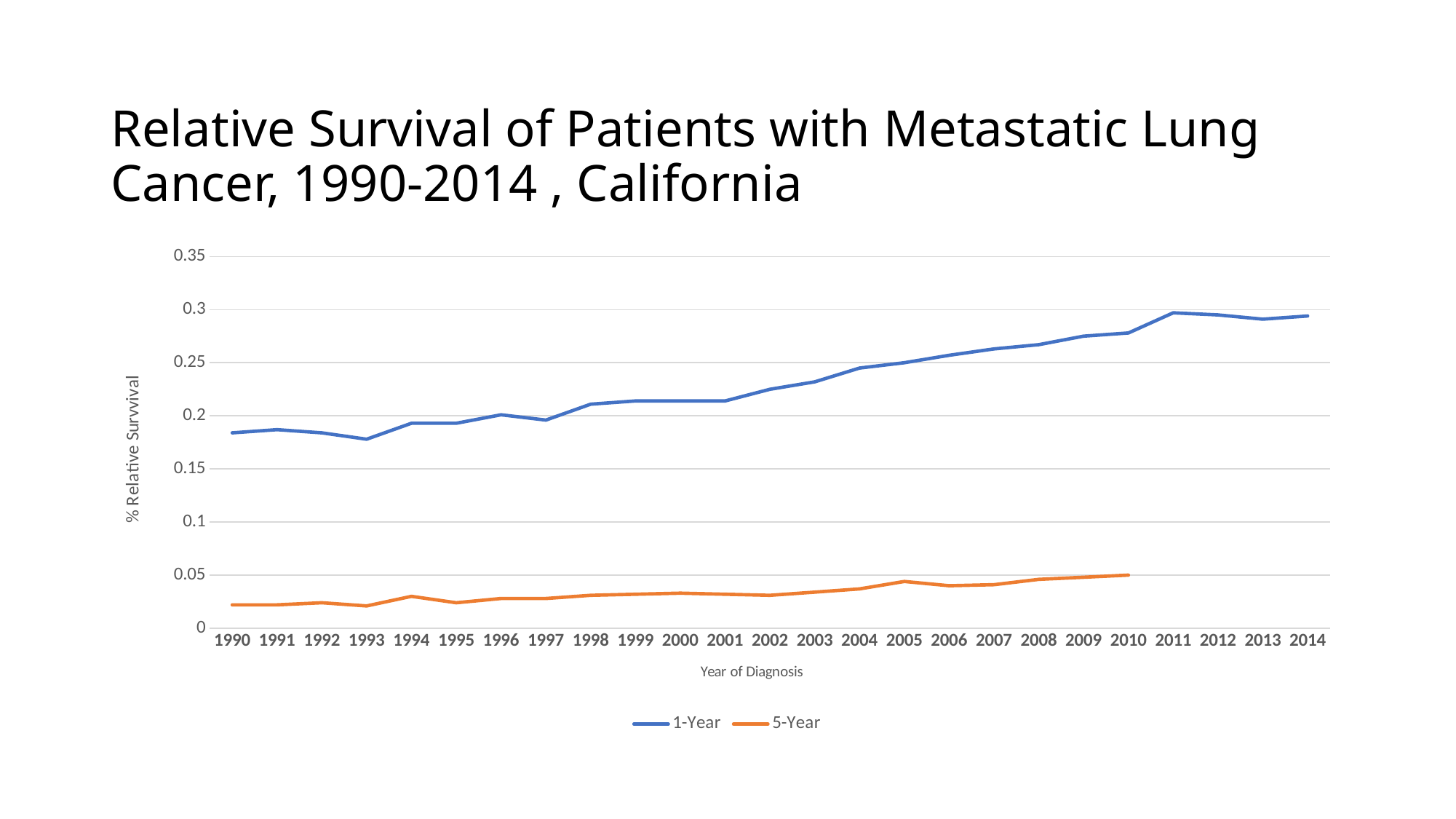
What kind of chart is shown on the slide? Line chart Which colour is used for the 5-Year series? Orange How many series does the legend list? 2 Which series has the larger value in 2000, 1-Year or 5-Year? 1-Year Is the 1-Year value for 2011 greater or less than 0.25? greater In which year is the 1-Year relative survival lowest? 1993 What is the label of the x axis? Year of Diagnosis Is the 1-Year value for 1990 greater or less than 0.2? less Does the 1-Year relative survival rise or fall overall from 1990 to 2014? Rise Is the 5-Year value for 1990 greater or less than 0.05? less How many years are shown along the x axis? 25 Does the 5-Year relative survival rise or fall overall from 1990 to 2010? Rise